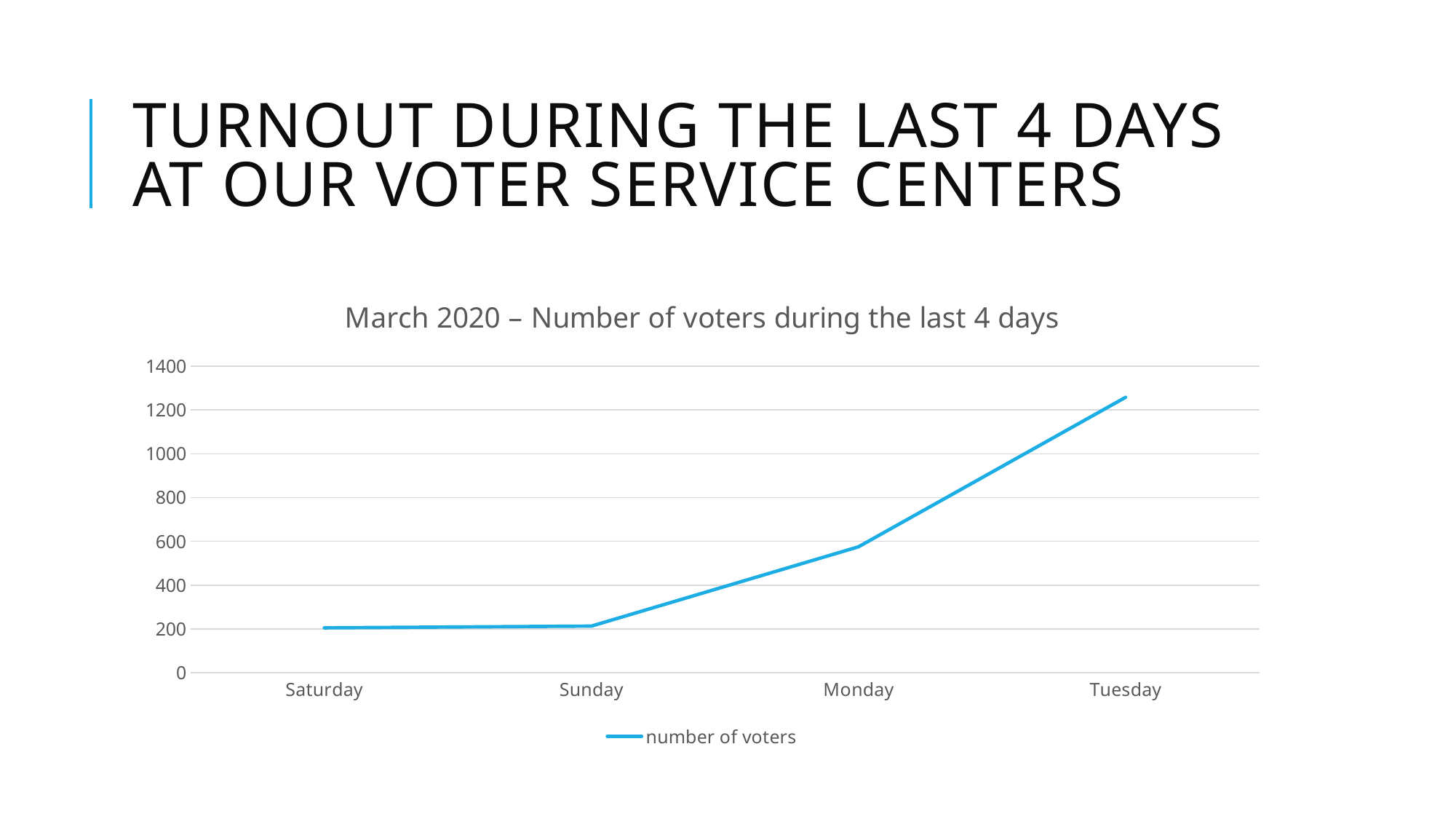
Is the number of voters on Tuesday greater or less than 1200? greater Which day has more voters, Monday or Tuesday? Tuesday What is the name of the series shown in the legend? number of voters Does the number of voters rise or fall from Sunday to Tuesday? rise What kind of chart is shown on the slide? line chart How many days are plotted along the x axis? 4 Is the number of voters on Saturday greater or less than 400? less How many series does the legend list? 1 What is the title of the chart? March 2020 – Number of voters during the last 4 days Is the number of voters on Tuesday greater or less than 1400? less Which day has the highest number of voters? Tuesday